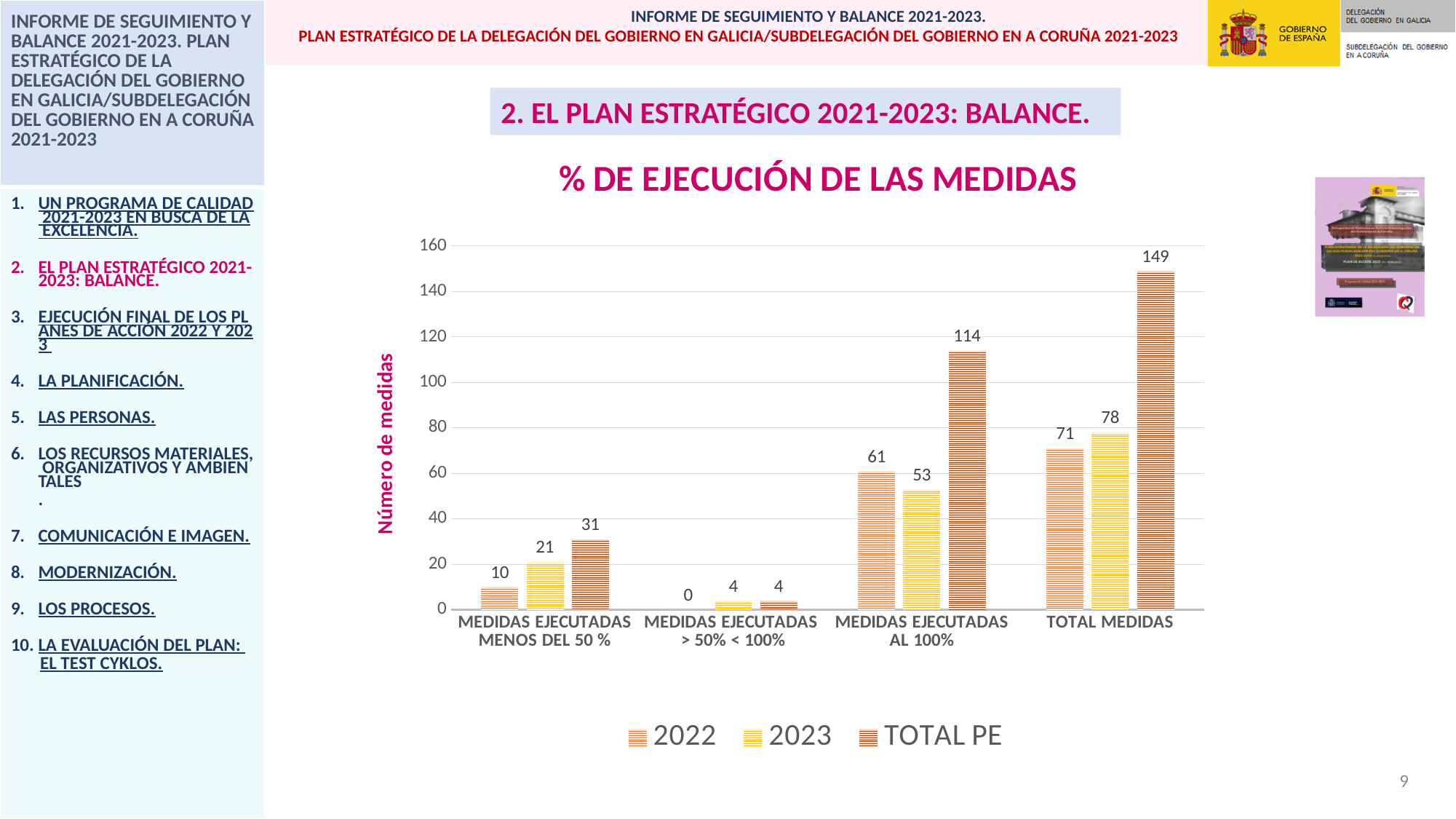
What is the difference between the 2023 and 2022 values for TOTAL MEDIDAS? 7 What is the title of the chart? % DE EJECUCIÓN DE LAS MEDIDAS Which is larger for MEDIDAS EJECUTADAS AL 100%: the 2022 value or the 2023 value? 2022 What is the 2022 value for MEDIDAS EJECUTADAS AL 100%? 61 Which category has the lowest 2023 value? MEDIDAS EJECUTADAS > 50% < 100% What is the TOTAL PE value for TOTAL MEDIDAS? 149 Which category has the highest TOTAL PE value? TOTAL MEDIDAS What is the 2023 value for MEDIDAS EJECUTADAS MENOS DEL 50 %? 21 What is the 2022 value for MEDIDAS EJECUTADAS > 50% < 100%? 0 What kind of chart is shown on the slide? Bar chart How many series does the legend list? 3 How many categories are shown on the x axis? 4